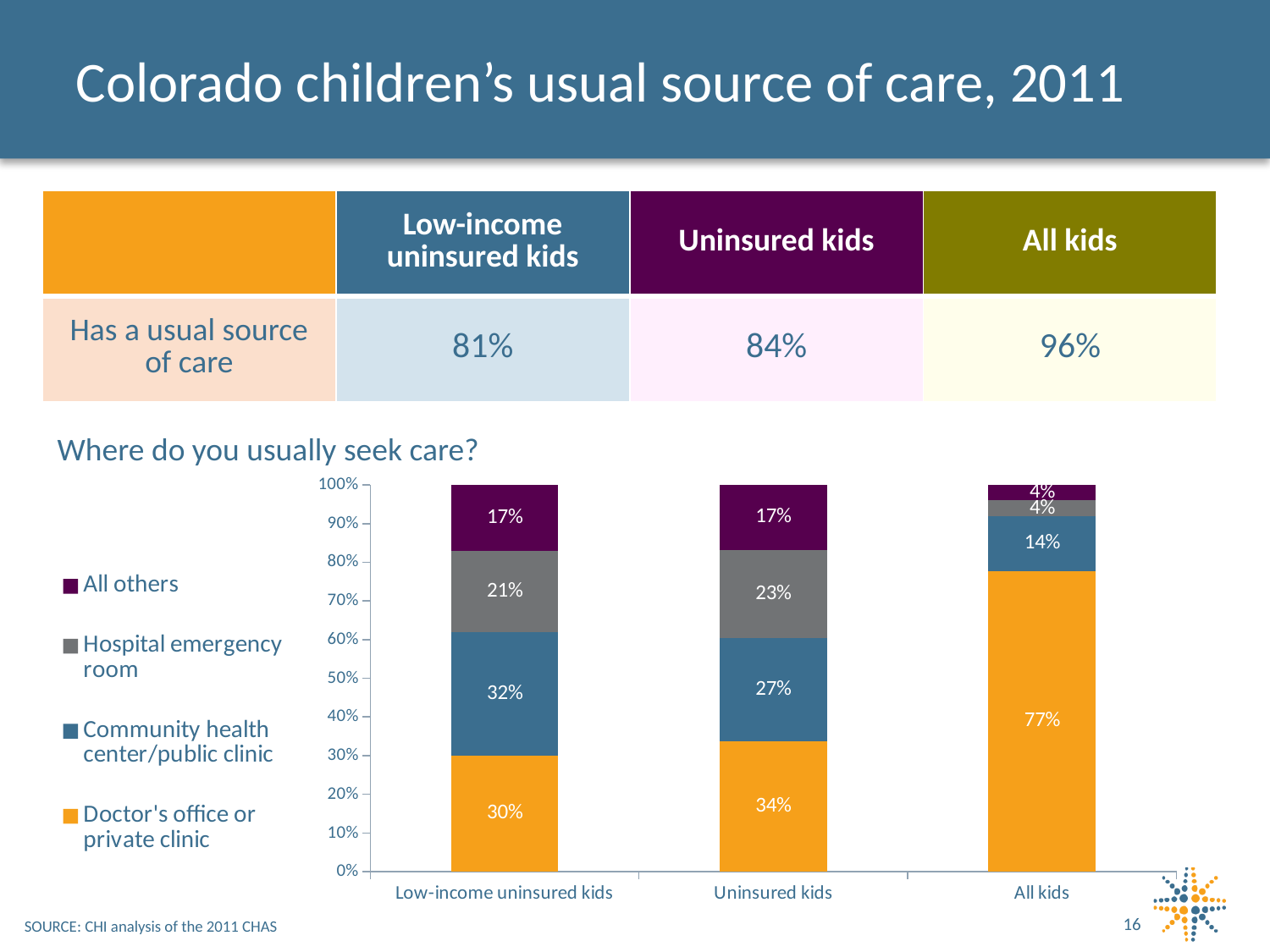
Which category in the chart has the highest share for doctor's office or private clinic? All kids In the chart, which colour represents "All others"? Purple In the chart, what is the difference between the doctor's office or private clinic share for All kids and for Low-income uninsured kids? 47% In the chart, what share of Uninsured kids usually seek care at a hospital emergency room? 23% In the chart, what is the "All others" share for Uninsured kids? 17% In the chart, what share of All kids usually seek care at a doctor's office or private clinic? 77% In the chart, what share of Low-income uninsured kids usually seek care at a community health center/public clinic? 32% What kind of chart is shown under "Where do you usually seek care?"? Stacked bar chart How many series does the chart's legend list? 4 In the chart, which is larger: the community health center/public clinic share for Low-income uninsured kids or for Uninsured kids? Low-income uninsured kids How many categories are shown on the x axis of the chart? 3 Which category in the chart has the lowest share for hospital emergency room? All kids